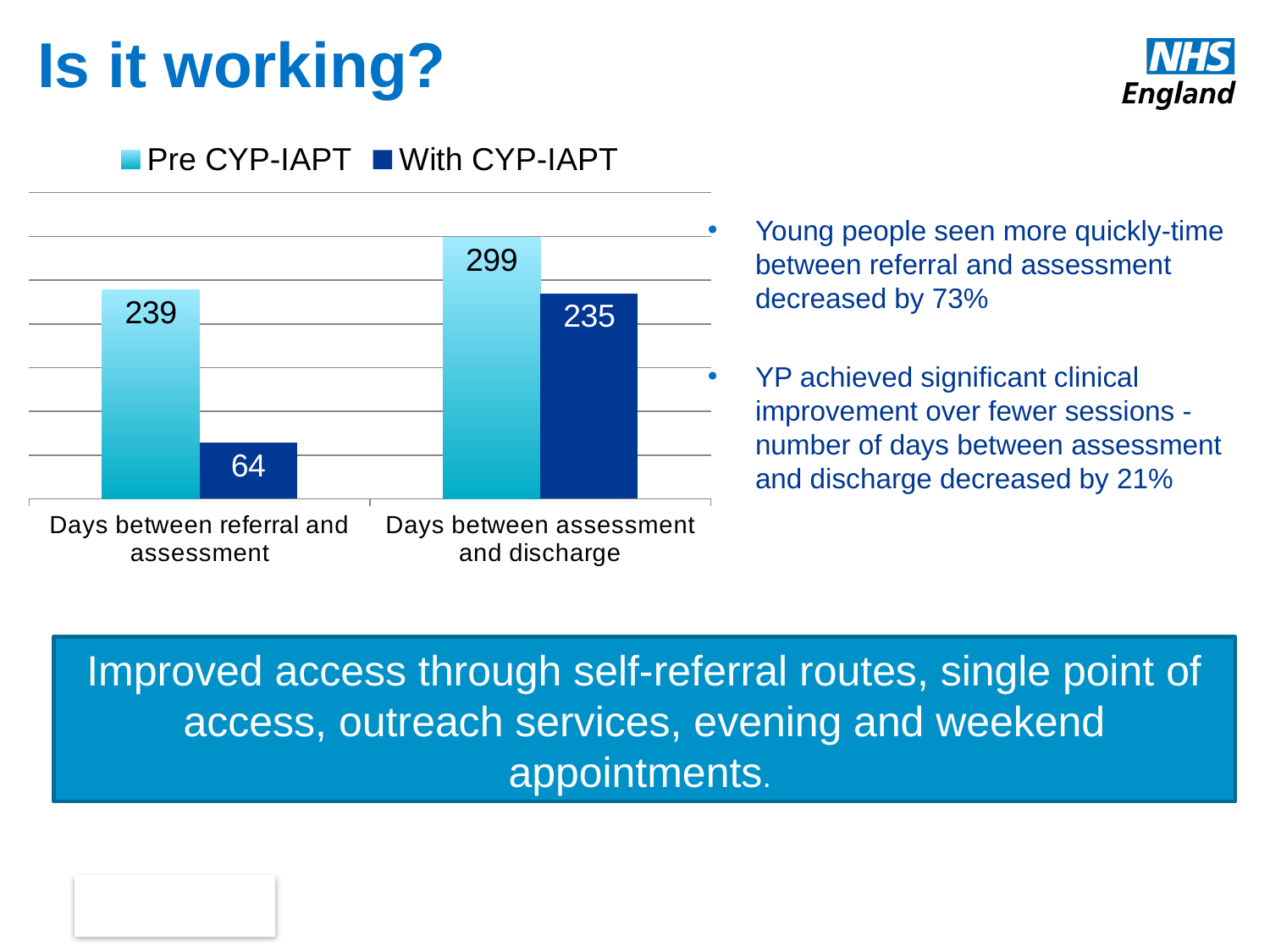
What is the Pre CYP-IAPT value for Days between referral and assessment? 239 Which bar in the chart has the highest value? Pre CYP-IAPT, Days between assessment and discharge How many series does the chart legend list? 2 What kind of chart is shown on the slide? Bar chart Which bar in the chart has the lowest value? With CYP-IAPT, Days between referral and assessment What is the With CYP-IAPT value for Days between referral and assessment? 64 What is the With CYP-IAPT value for Days between assessment and discharge? 235 How many categories are shown on the x axis of the chart? 2 What is the difference between the Pre CYP-IAPT and With CYP-IAPT values for Days between referral and assessment? 175 What is the difference between the Pre CYP-IAPT and With CYP-IAPT values for Days between assessment and discharge? 64 What is the Pre CYP-IAPT value for Days between assessment and discharge? 299 Which is larger: the With CYP-IAPT value for Days between referral and assessment or the With CYP-IAPT value for Days between assessment and discharge? Days between assessment and discharge